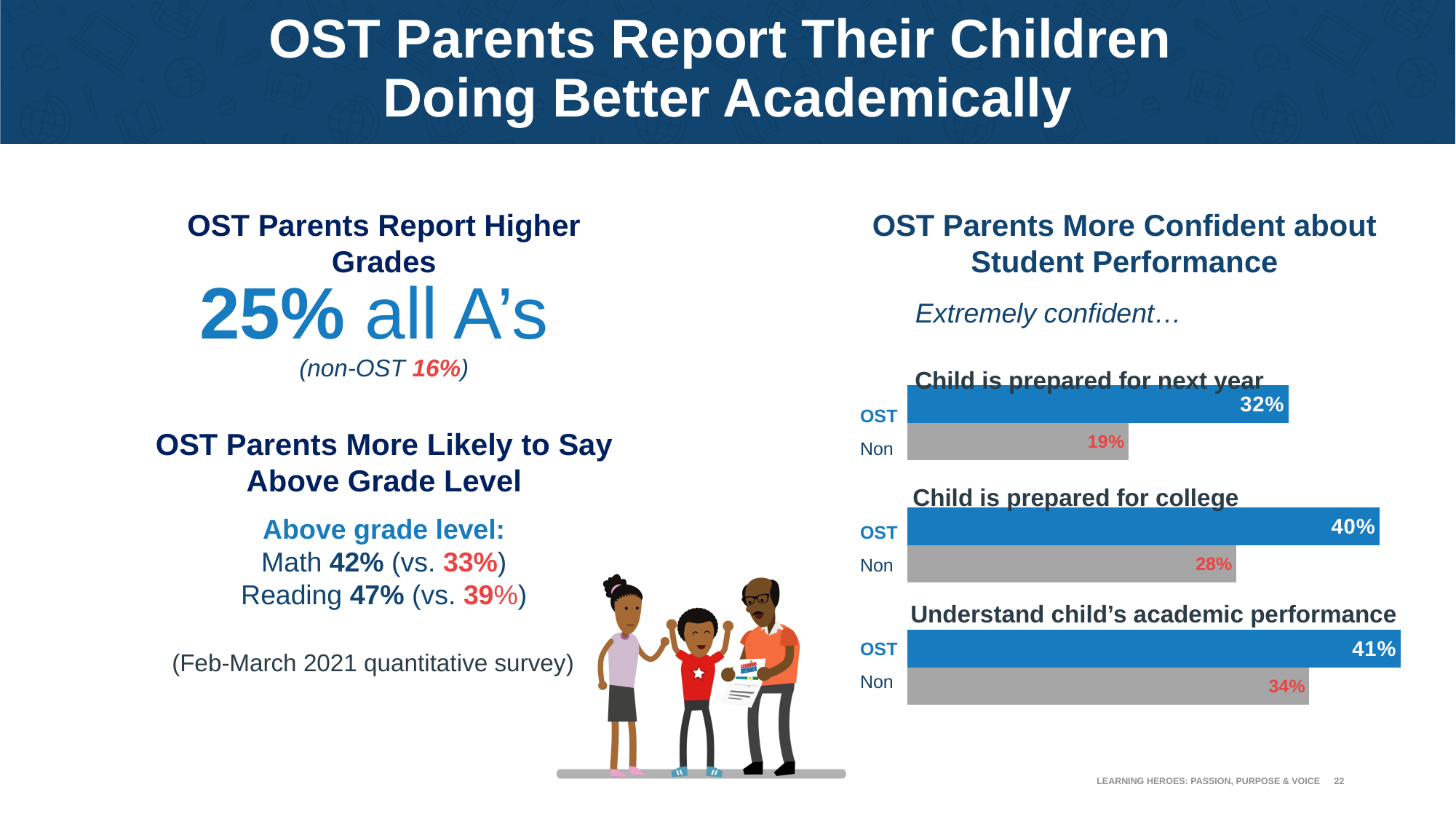
In the 'Child is prepared for college' chart, what is the value for OST? 40% In the 'Child is prepared for next year' chart, what is the value for OST? 32% What kind of chart is used for 'Child is prepared for next year'? Bar chart In the 'Child is prepared for college' chart, what is the value for Non? 28% In the 'Child is prepared for next year' chart, what is the difference between the OST and Non values? 13% In the 'Understand child's academic performance' chart, what is the value for Non? 34% In the 'Child is prepared for next year' chart, what is the value for Non? 19% In the 'Child is prepared for college' chart, which bar is the lowest? Non In the 'Understand child's academic performance' chart, which is larger, OST or Non? OST In the 'Understand child's academic performance' chart, what is the value for OST? 41% How many bars are in the 'Understand child's academic performance' chart? 2 In the 'Child is prepared for college' chart, what is the difference between the OST and Non values? 12%